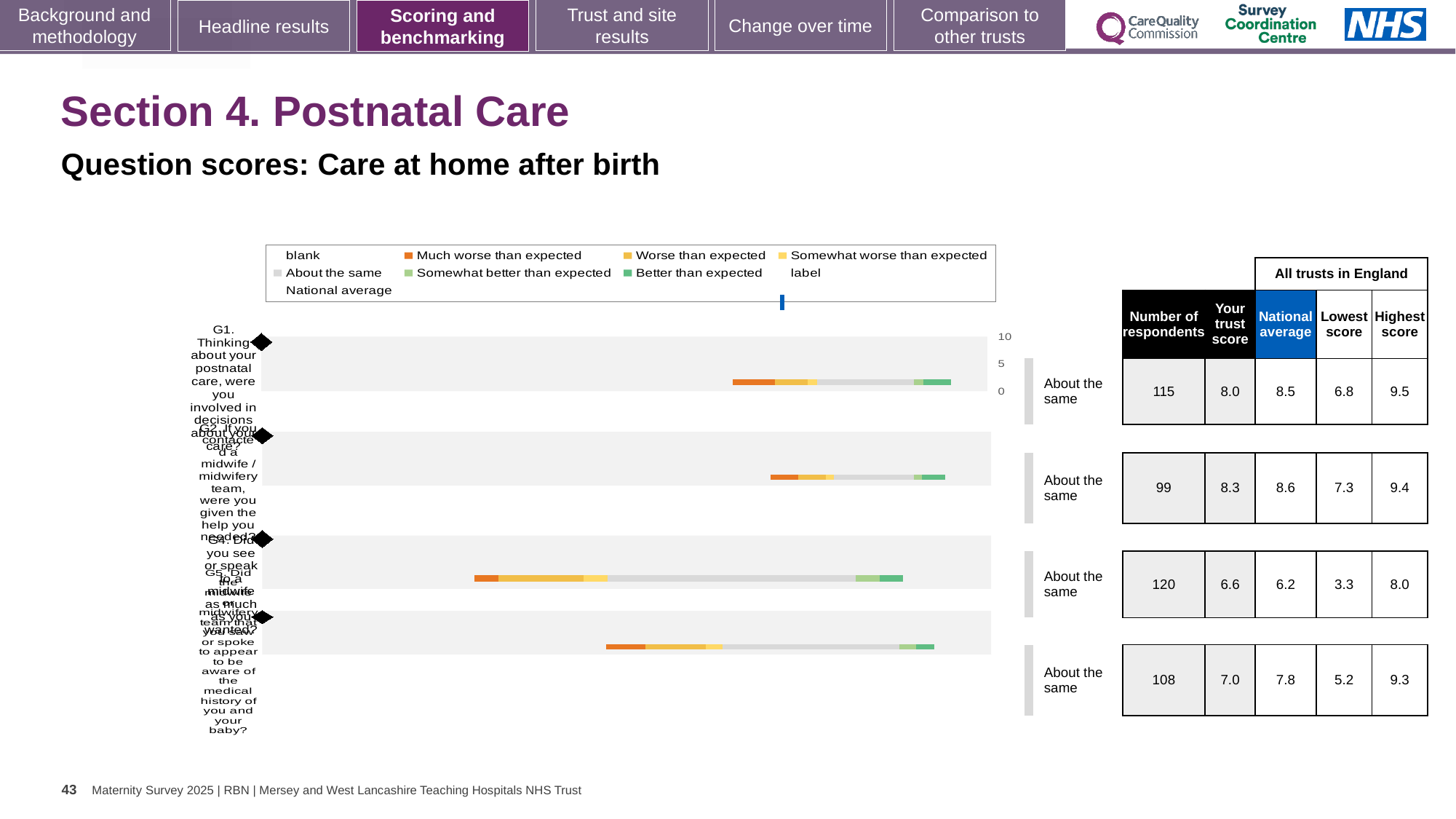
For question G1, what is the difference between the national average and the trust score? 0.5 What is the highest score among all trusts in England for question G2? 9.4 What benchmark category is shown next to the bar for question G1? About the same What kind of chart is shown on the slide? bar chart What is the lowest score among all trusts in England for question G4? 3.3 What is the trust score for question G4? 6.6 For question G4, which is larger: the trust score or the national average? the trust score Which question has the highest trust score? G2 Which question has the lowest trust score? G4 How many questions (bars) are plotted in the chart? 4 What is the national average for question G5? 7.8 What is the number of respondents for question G1? 115